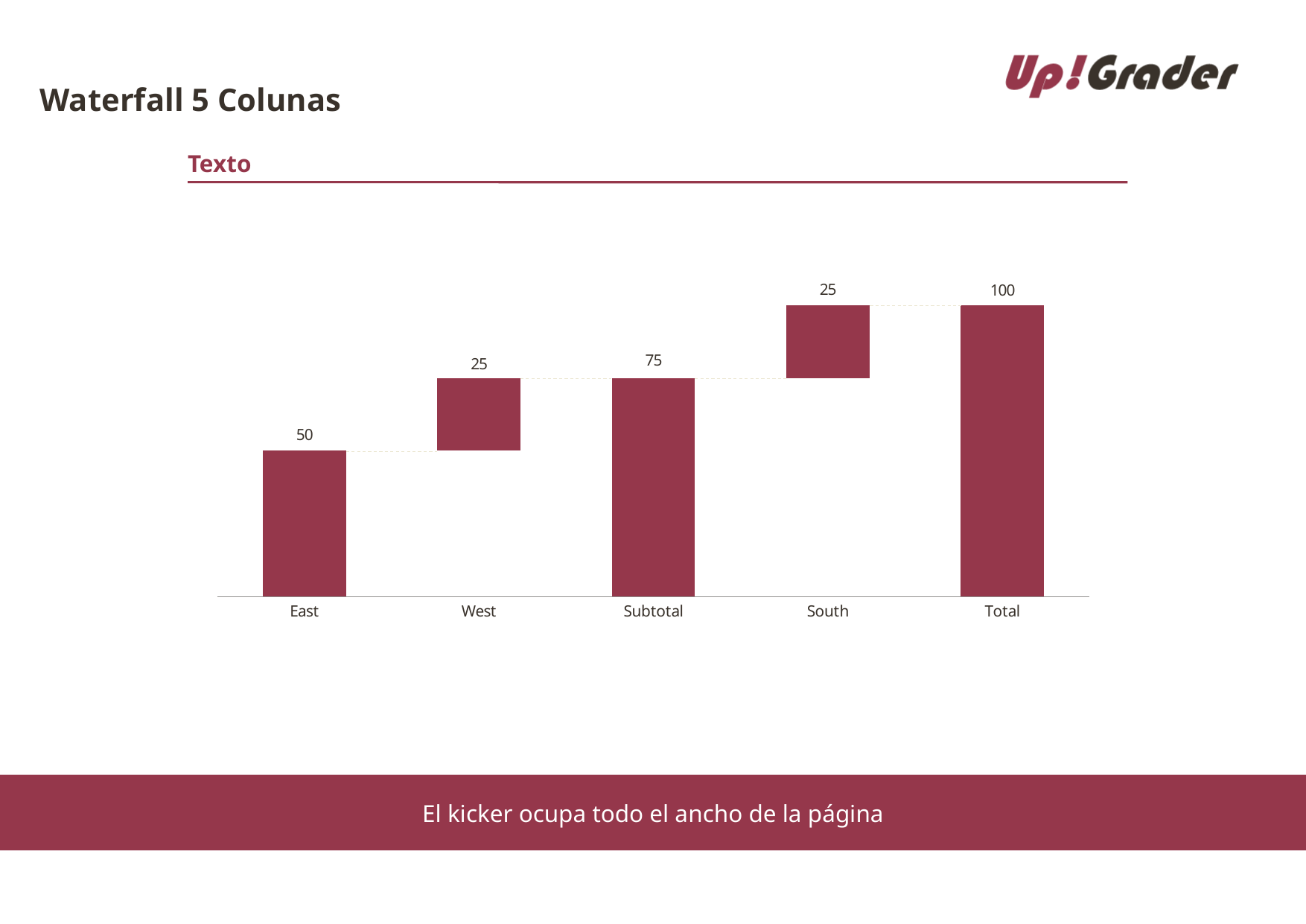
What is the value shown for Total? 100 What is the value shown for West? 25 What is the value shown for Subtotal? 75 What is the difference between the Total value and the Subtotal value? 25 How many categories are shown on the x axis? 5 What is the difference between the East value and the West value? 25 Which is larger, the value for East or the value for West? East What is the value shown for South? 25 Which category has the highest value? Total What is the value shown for East? 50 What kind of chart is shown on the slide? waterfall chart